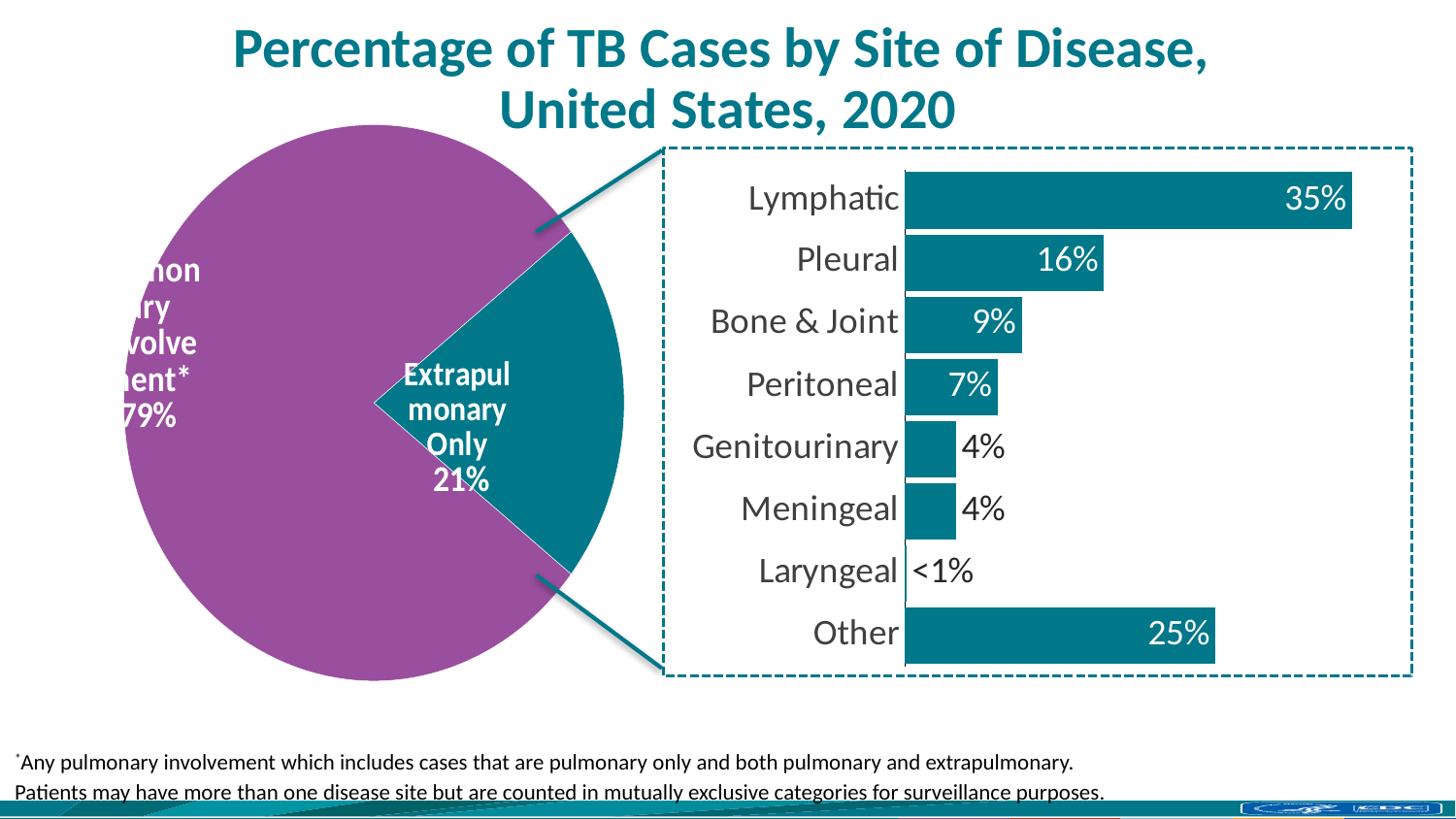
In the pie chart, what share is shown for Extrapulmonary Only? 21% What kind of chart is the chart on the left side of the slide? Pie chart How many sites are listed in the bar chart? 8 In the bar chart, what is the value for Lymphatic? 35% In the bar chart, what is the value for Laryngeal? <1% In the bar chart, which site has the highest percentage? Lymphatic In the bar chart, which is larger, Other or Pleural? Other In the bar chart, what is the value for Pleural? 16% In the bar chart, what is the value for Other? 25% In the bar chart, which site has the lowest percentage? Laryngeal What kind of chart is the chart on the right side of the slide? Bar chart In the bar chart, what is the difference between the Lymphatic and Pleural values? 19 percentage points